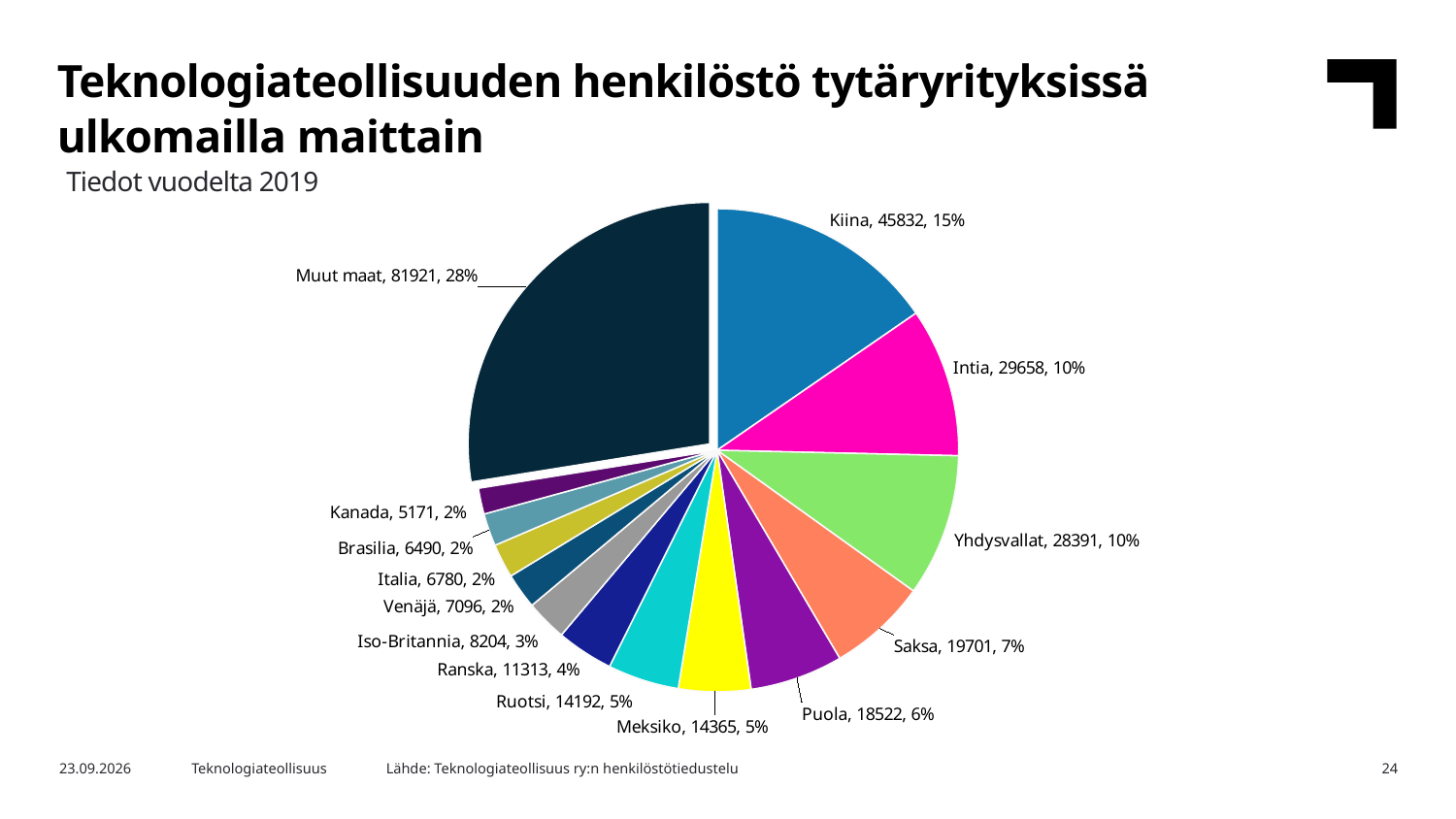
What percentage share is shown for Ranska? 4% What kind of chart is shown on the slide? Pie chart How many slices does the pie chart have? 14 What is the value for Kiina? 45832 Which is larger, the value for Puola or the value for Meksiko? Puola What is the difference between the values for Intia and Yhdysvallat? 1267 Which slice is the smallest? Kanada What year do the data on the slide refer to? 2019 What share of the pie does Muut maat represent? 28% What is the value for Iso-Britannia? 8204 Which slice is the largest? Muut maat What is the value for Saksa? 19701